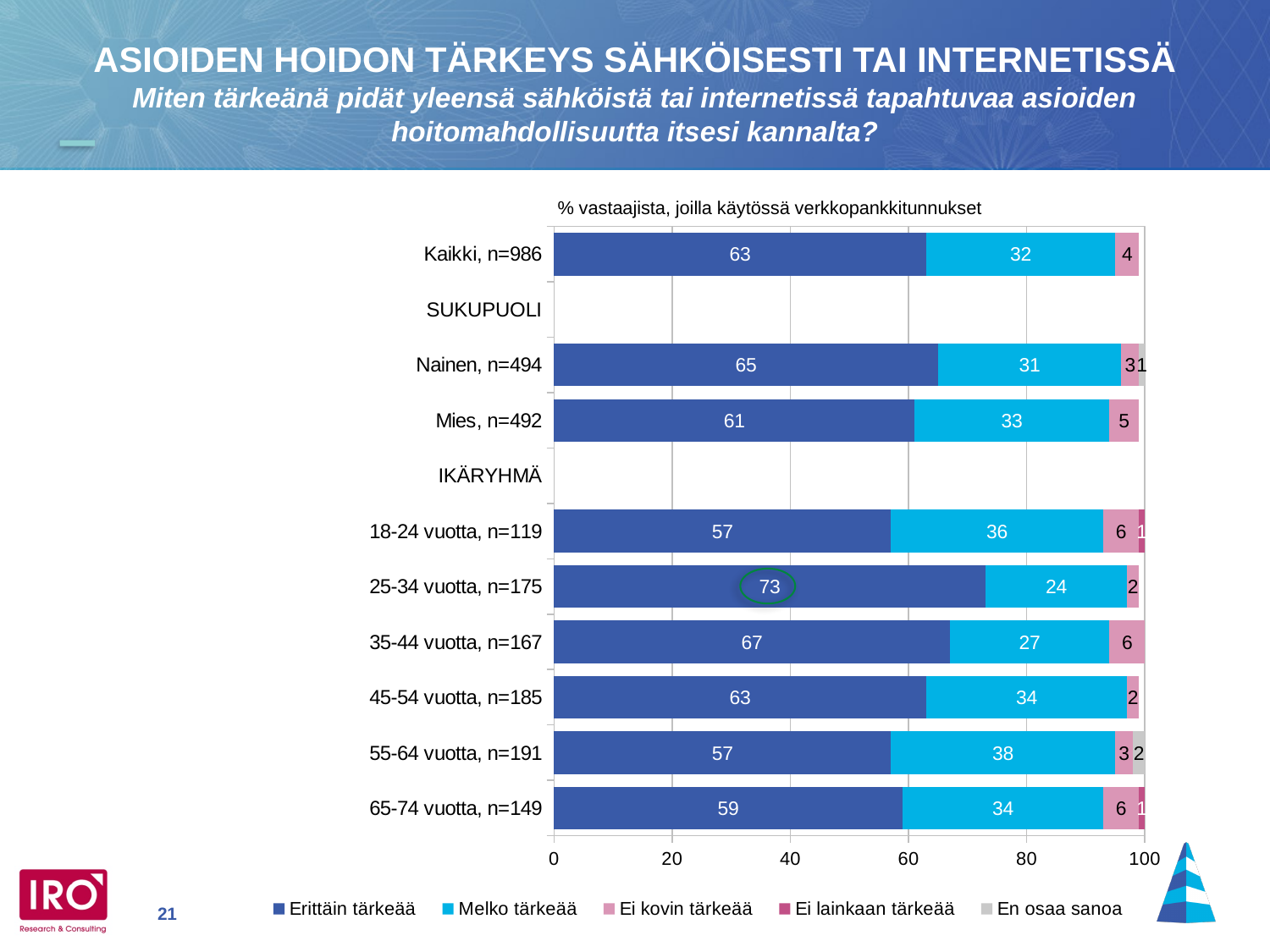
What percentage of all respondents (Kaikki, n=986) answered "Erittäin tärkeää"? 63 What is the first legend entry of the chart? Erittäin tärkeää Which age group has the lowest "Melko tärkeää" value? 25-34 vuotta, n=175 How many age groups (IKÄRYHMÄ) are plotted in the chart? 6 What is the difference between the "Erittäin tärkeää" values for Nainen and Mies? 4 What is the "Ei kovin tärkeää" value for Mies, n=492? 5 Which age group has the highest "Erittäin tärkeää" value? 25-34 vuotta, n=175 Which has a larger "Erittäin tärkeää" value, 35-44 vuotta or 45-54 vuotta? 35-44 vuotta How many series does the legend list? 5 What is the "Melko tärkeää" value for the 55-64 vuotta age group? 38 Which value in the chart is circled? 73 What type of chart is shown on the slide? Stacked bar chart